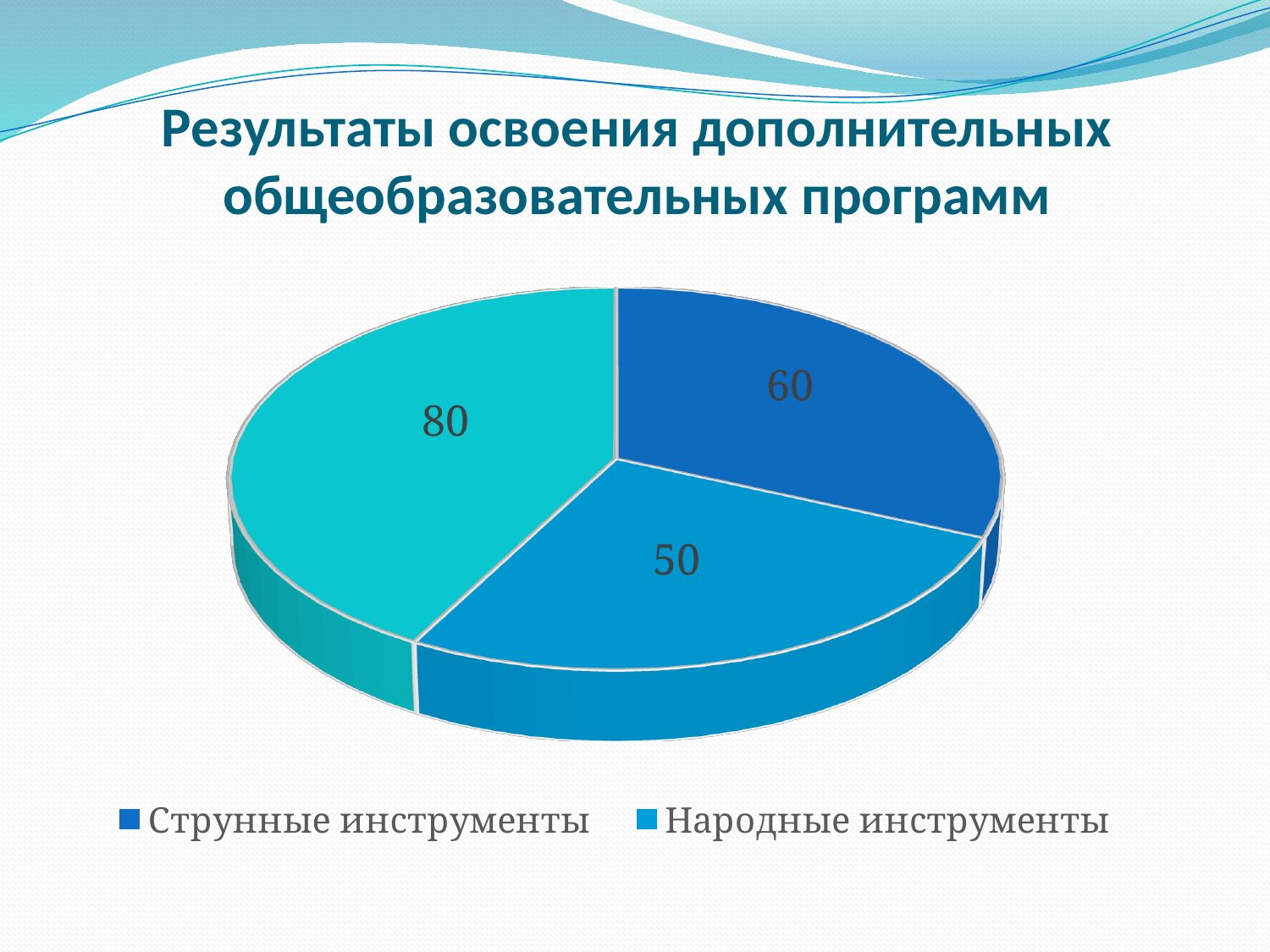
What is the total of all the values printed on the pie slices? 190 What is the difference between the values for Струнные инструменты and Народные инструменты? 10 Which legend category has the smallest slice? Народные инструменты What value is printed on the teal (left) slice of the pie? 80 What value is shown for the slice labelled Народные инструменты? 50 What is the title of the slide? Результаты освоения дополнительных общеобразовательных программ What value is shown for the slice labelled Струнные инструменты? 60 What is the largest value printed on any slice of the pie? 80 Which is larger, the slice for Струнные инструменты or the slice for Народные инструменты? Струнные инструменты How many slices does the pie chart have? 3 How many entries does the legend list? 2 What kind of chart is shown on the slide? pie chart